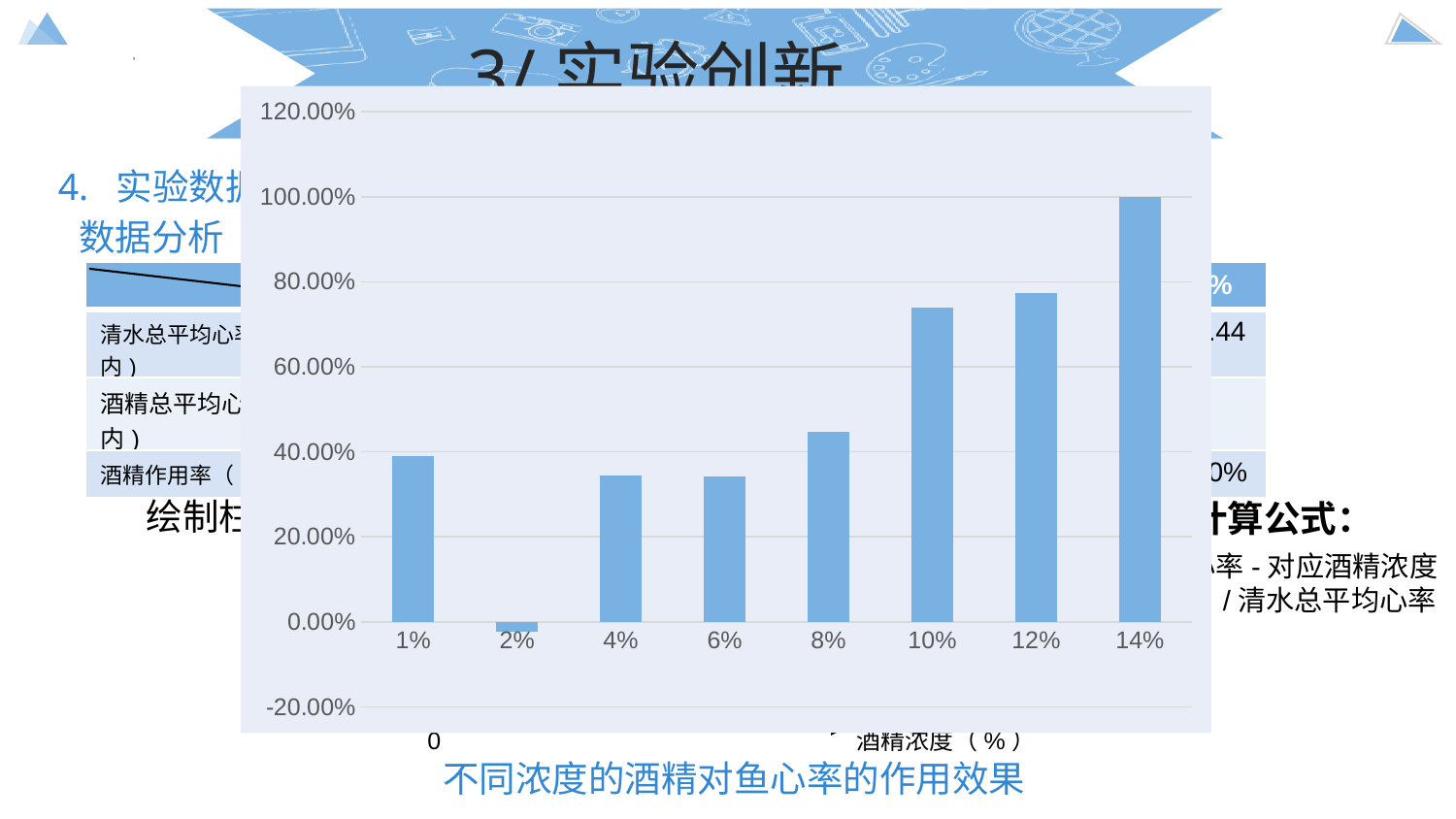
What is the value for the 14% alcohol concentration? 100.00% Which alcohol concentration has the lowest bar? 2% Which has the larger value, the 10% concentration or the 8% concentration? 10% Is the value for the 6% concentration greater or less than 40.00%? less Is the value for the 10% concentration greater or less than 60.00%? greater Which alcohol concentration has the highest bar? 14% What kind of chart is shown on the slide? bar chart Do the values rise or fall along the x axis from 4% to 14%? rise Is the value for the 1% concentration greater or less than 20.00%? greater How many alcohol concentration categories are plotted on the x axis? 8 What is the title shown below the chart? 不同浓度的酒精对鱼心率的作用效果